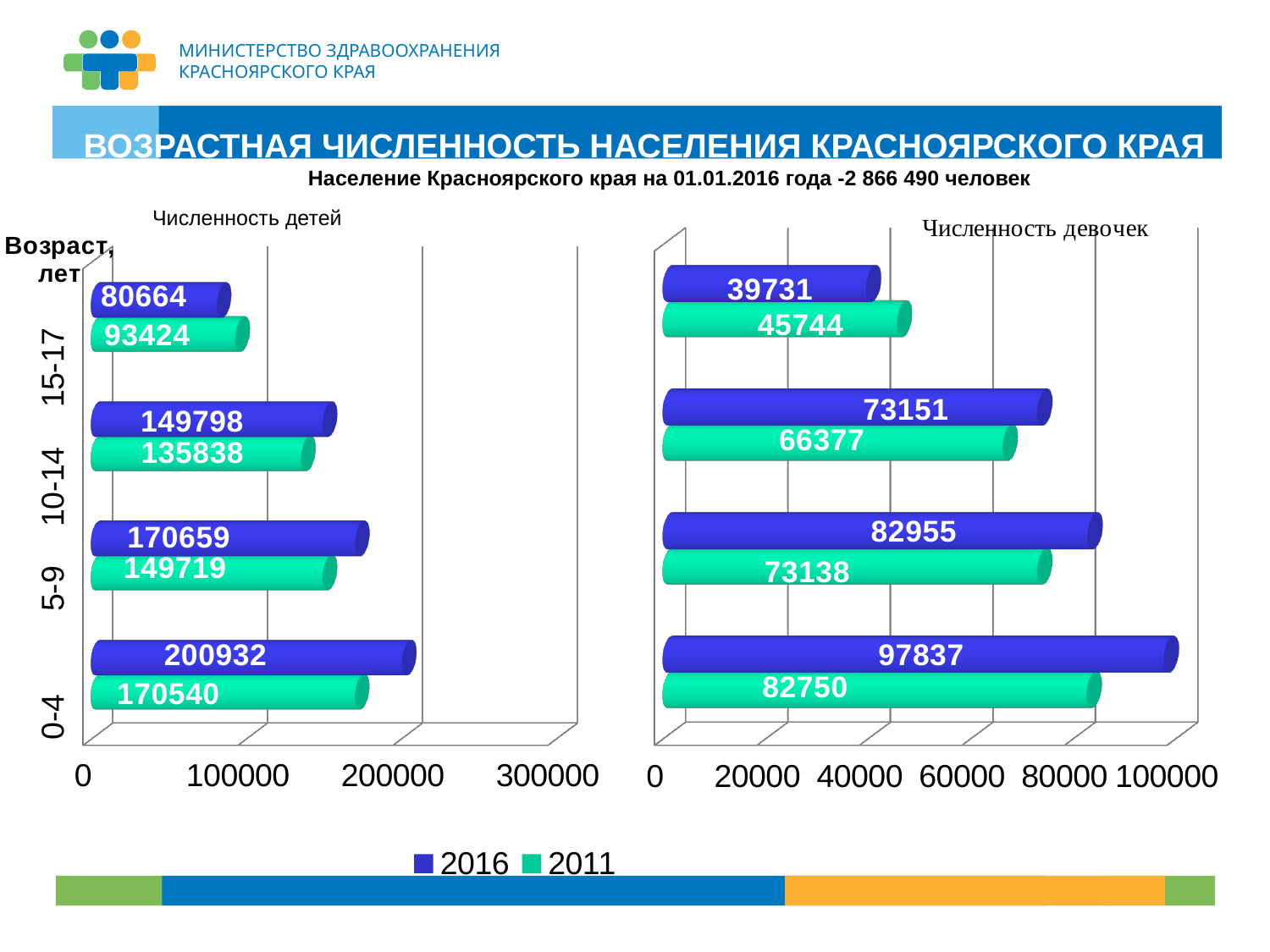
In the chart titled "Численность детей", what is the difference between the 2016 and 2011 values for the 5-9 age group? 20940 Which colour represents the 2011 series in the legend? green How many age groups are shown in the chart titled "Численность детей"? 4 In the chart titled "Численность девочек", is the 2016 value for the 10-14 age group greater or less than 60000? greater How many series does the legend list? 2 In the chart titled "Численность детей", which is larger for the 15-17 age group: the 2016 value or the 2011 value? 2011 In the chart titled "Численность девочек", which age group has the lowest value for 2011? 15-17 What kind of chart is the chart titled "Численность девочек"? bar chart In the chart titled "Численность детей", what is the value for the 0-4 age group in 2016? 200932 In the chart titled "Численность девочек", what is the value for the 15-17 age group in 2011? 45744 In the chart titled "Численность девочек", what is the difference between the 2016 and 2011 values for the 0-4 age group? 15087 In the chart titled "Численность детей", which age group has the highest value for 2016? 0-4